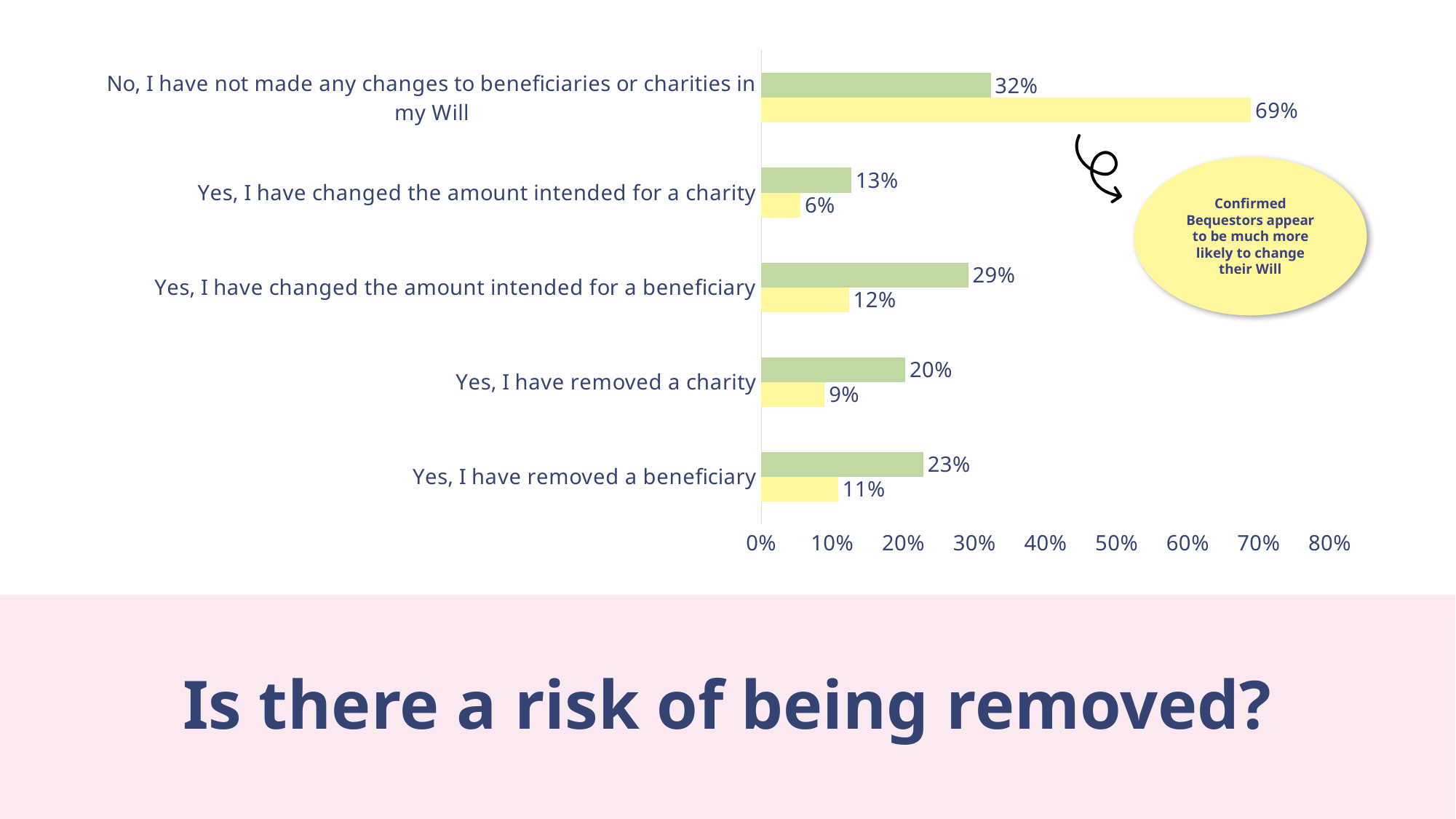
What is the value of the yellow bar for "Yes, I have removed a beneficiary"? 11% Which category has the lowest yellow bar value? Yes, I have changed the amount intended for a charity What does the yellow callout on the slide say? Confirmed Bequestors appear to be much more likely to change their Will What is the difference between the yellow and green bars for "No, I have not made any changes to beneficiaries or charities in my Will"? 37% What is the value of the yellow bar for "Yes, I have removed a charity"? 9% What is the value of the yellow bar for "No, I have not made any changes to beneficiaries or charities in my Will"? 69% What is the value of the green bar for "Yes, I have changed the amount intended for a beneficiary"? 29% What kind of chart is shown on the slide? bar chart For "Yes, I have removed a beneficiary", which bar is larger, the green or the yellow? green How many categories does the chart show? 5 Which category has the highest green bar value? No, I have not made any changes to beneficiaries or charities in my Will What is the value of the green bar for "No, I have not made any changes to beneficiaries or charities in my Will"? 32%